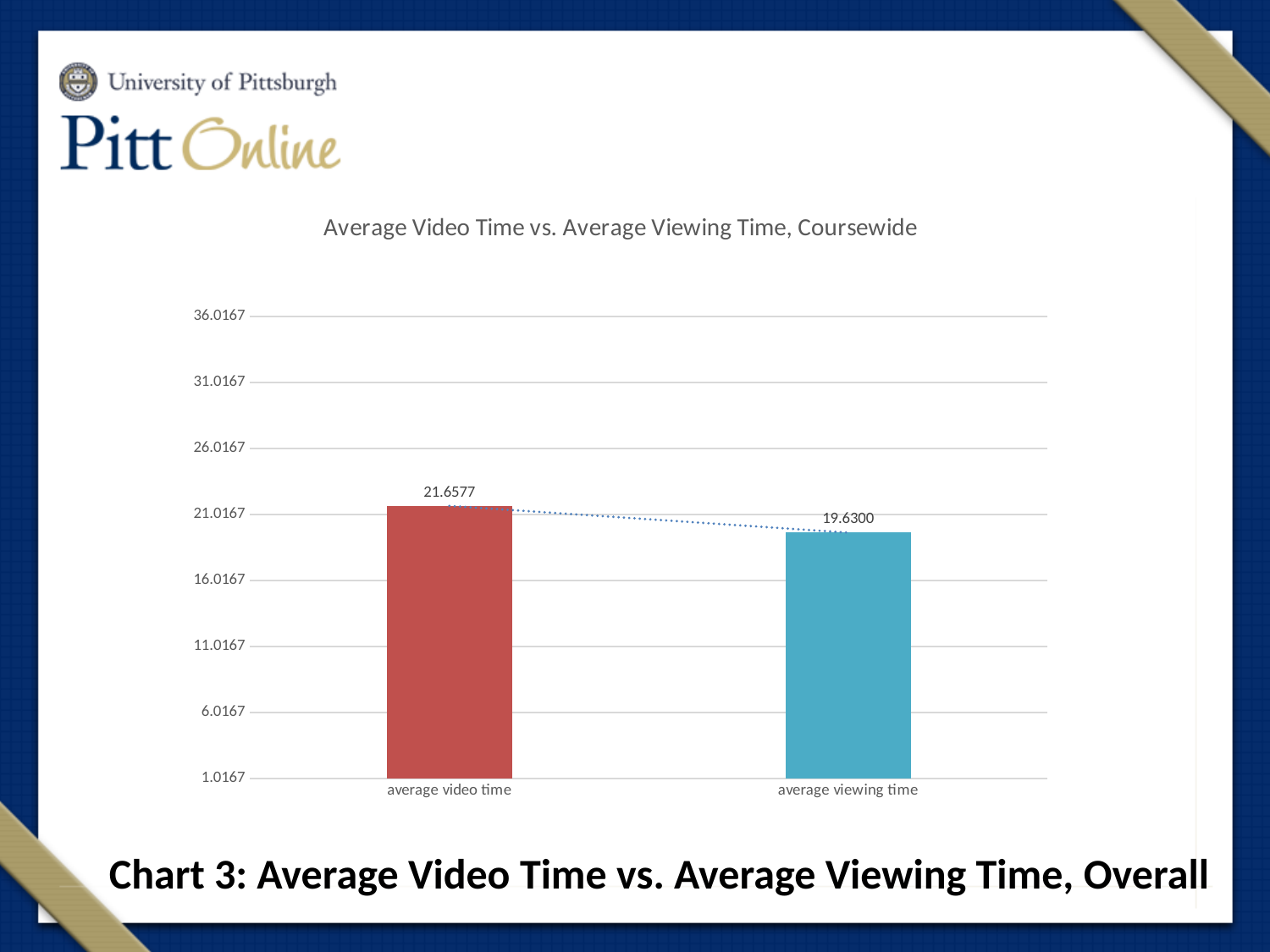
What is the difference between average video time and average viewing time? 2.0277 Do the values rise or fall from average video time to average viewing time? fall What is the value for average viewing time? 19.6300 Which category has the higher value? average video time Is the value for average viewing time greater or less than 16.0167? greater What is the value for average video time? 21.6577 What colour is the bar for average video time? red Is average video time larger or smaller than average viewing time? larger What is the title of the chart? Average Video Time vs. Average Viewing Time, Coursewide How many categories are shown on the x axis? 2 What kind of chart is shown on the slide? bar chart Which category has the lower value? average viewing time